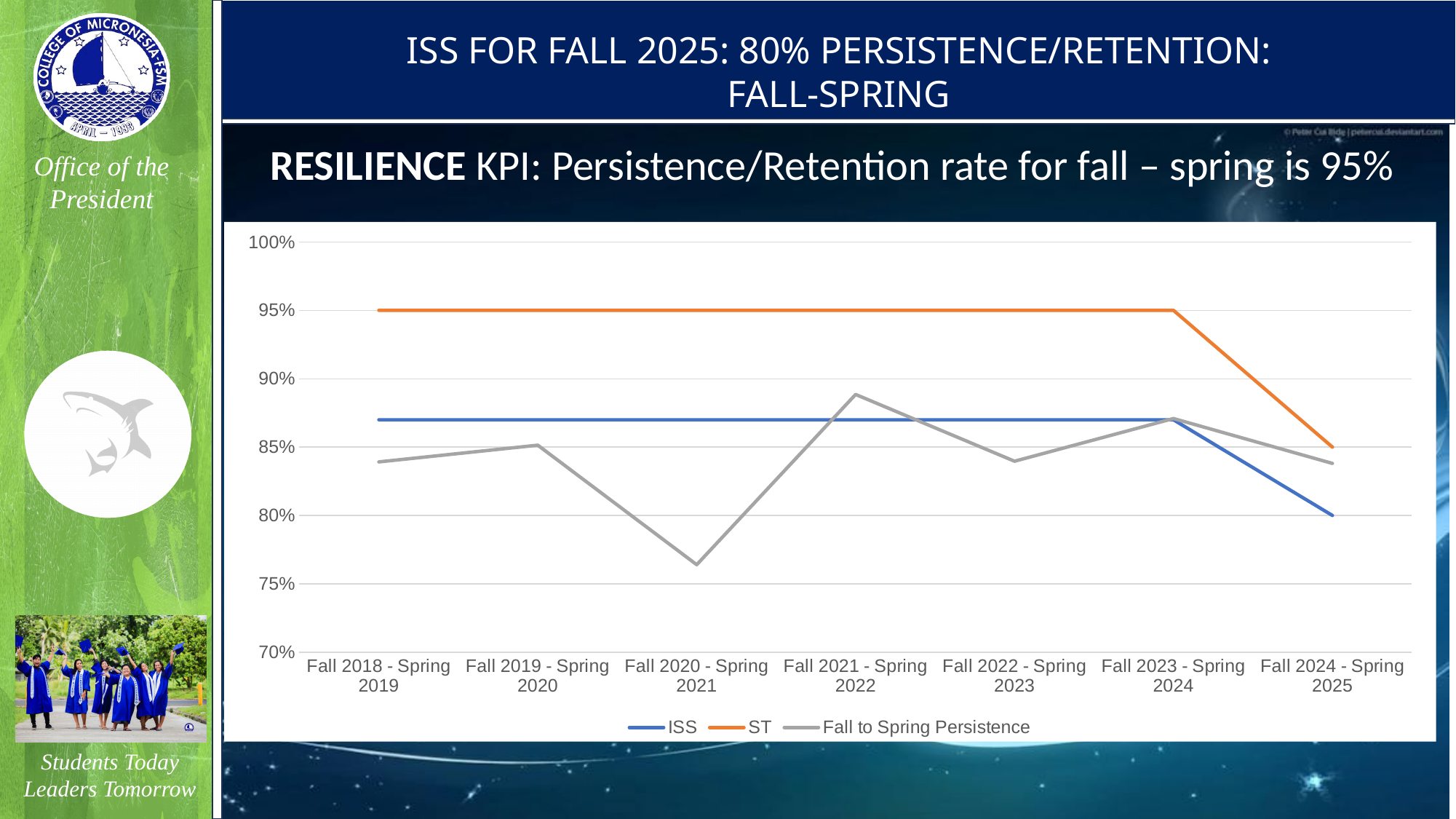
What is the difference between the ST and ISS values for Fall 2024 - Spring 2025? 5 percentage points Which period has the lowest Fall to Spring Persistence value? Fall 2020 - Spring 2021 Does the ST line rise or fall between Fall 2023 - Spring 2024 and Fall 2024 - Spring 2025? fall Which series is shown in orange in the legend? ST How many series does the chart legend list? 3 What is the ST value for Fall 2024 - Spring 2025? 85% What is the ISS value for Fall 2024 - Spring 2025? 80% What is the ST value for Fall 2018 - Spring 2019? 95% Which period has the highest Fall to Spring Persistence value? Fall 2021 - Spring 2022 How many academic-year periods are shown along the x axis? 7 Is the Fall to Spring Persistence value for Fall 2020 - Spring 2021 greater or less than 80%? less What kind of chart is shown on the slide? line chart